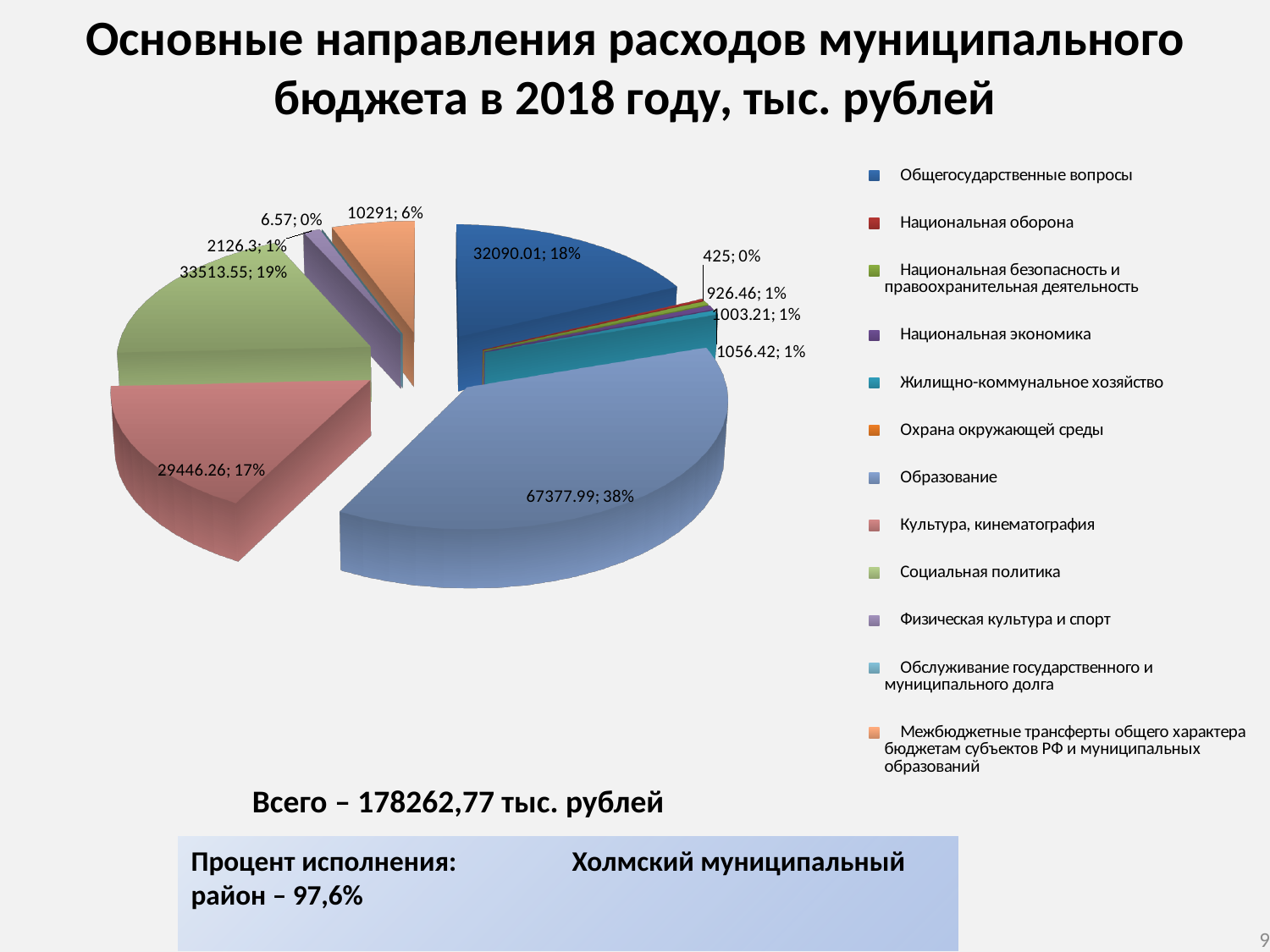
What total amount of expenditure is stated on the slide? 178262,77 тыс. рублей How many categories does the legend list? 12 What is the value for Образование? 67377.99 What kind of chart is shown on the slide? Pie chart Which category has the largest slice of the pie? Образование What share of the pie does Образование represent? 38% Which is larger: Социальная политика or Культура, кинематография? Социальная политика What is the value for Общегосударственные вопросы? 32090.01 What share of the pie does Социальная политика represent? 19% What is the value for Культура, кинематография? 29446.26 What is the value for Межбюджетные трансферты общего характера бюджетам субъектов РФ и муниципальных образований? 10291 What is the difference between the values for Социальная политика and Культура, кинематография? 4067.29